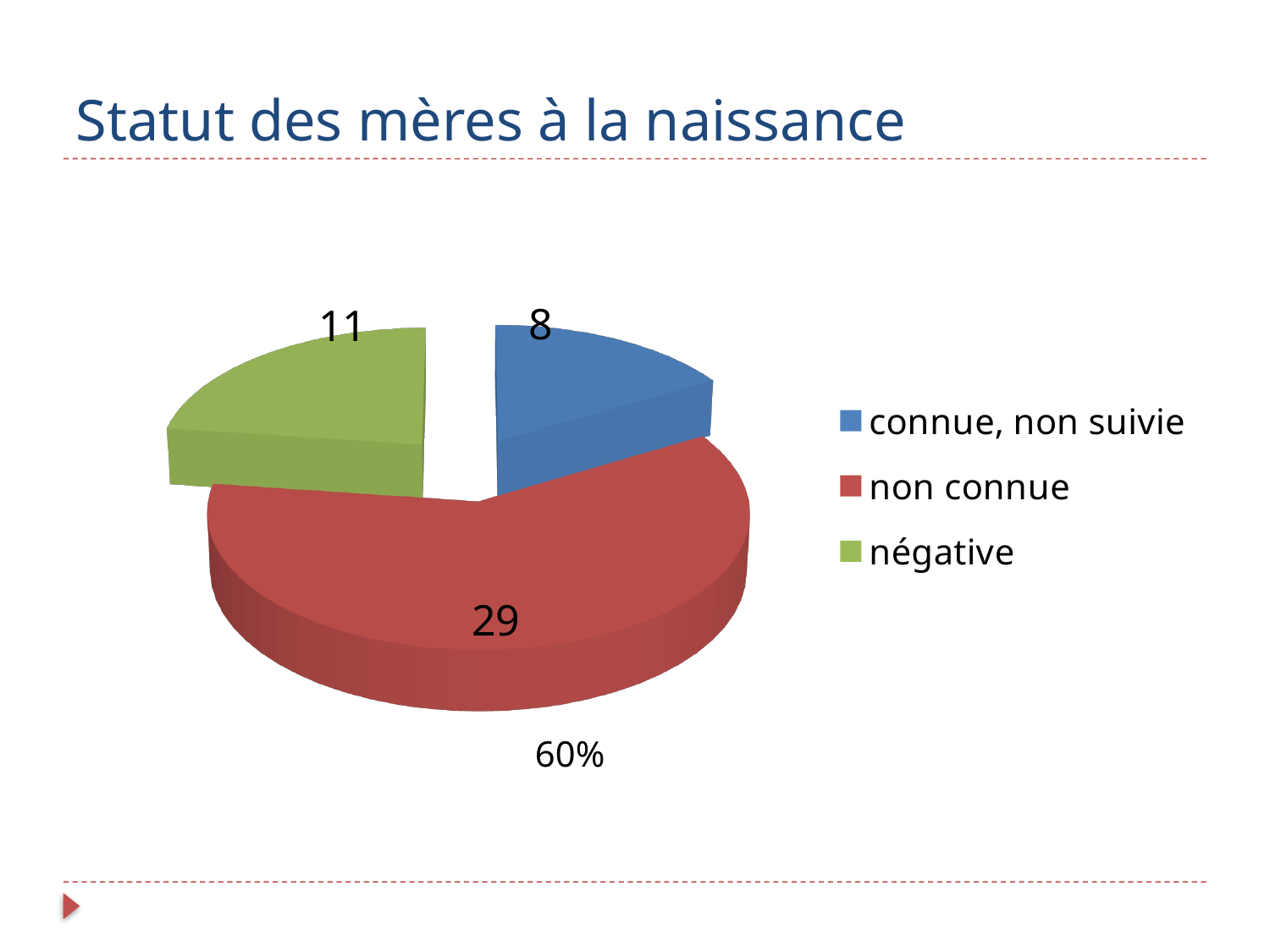
How many entries does the legend list? 3 What is the value for 'non connue'? 29 What is the title of the chart? Statut des mères à la naissance Which category has the largest slice? non connue Which category has the smallest slice? connue, non suivie Which is larger, the value for 'négative' or the value for 'connue, non suivie'? négative What type of chart is shown on the slide? pie chart What percentage share of the pie is labelled for the 'non connue' slice? 60% What is the value for 'négative'? 11 What is the value for 'connue, non suivie'? 8 What is the difference between the values for 'non connue' and 'négative'? 18 How many slices does the pie chart have? 3